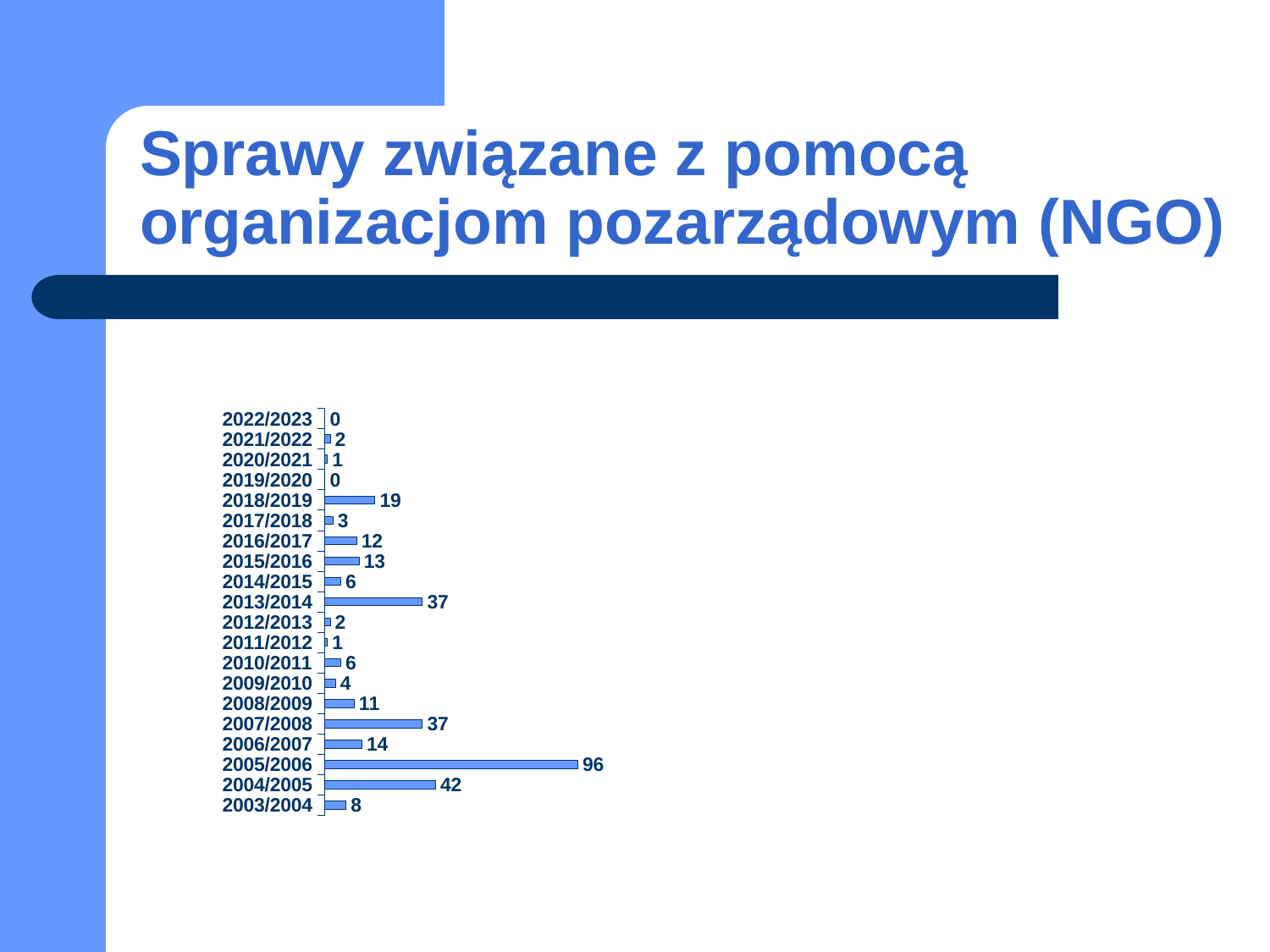
Which is larger, the value for 2006/2007 or the value for 2008/2009? 2006/2007 How many categories does the chart show? 20 What is the difference between the values for 2005/2006 and 2004/2005? 54 What is the value for 2005/2006? 96 Which category has the highest value? 2005/2006 Which categories have a value of 0? 2022/2023 and 2019/2020 What is the value for 2003/2004? 8 What is the value for 2018/2019? 19 What is the difference between the values for 2015/2016 and 2016/2017? 1 What kind of chart is shown on the slide? bar chart What is the title of the slide containing the chart? Sprawy związane z pomocą organizacjom pozarządowym (NGO) What is the value for 2013/2014? 37